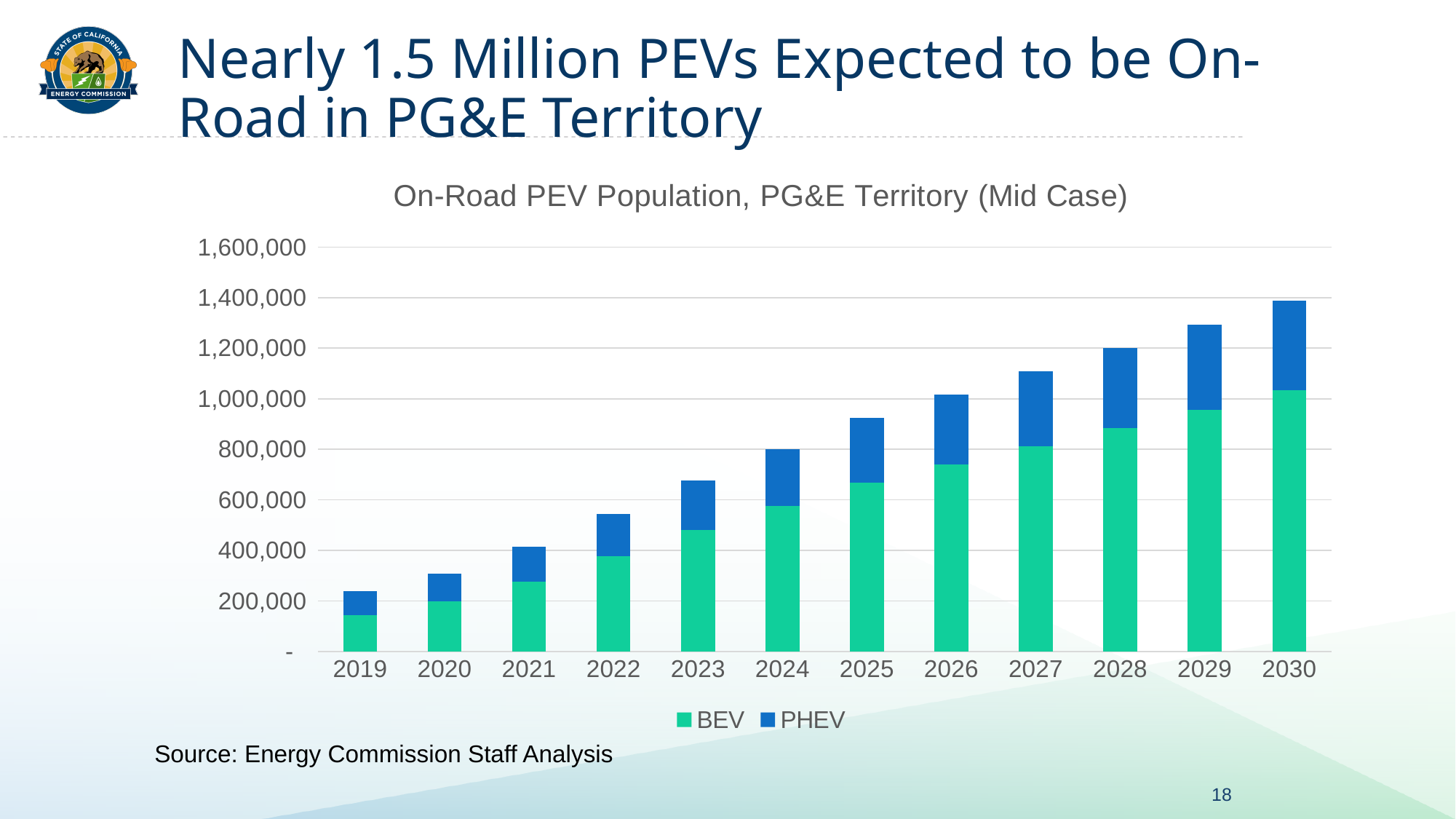
Which year has the lowest total on-road PEV population? 2019 How many series does the legend list? 2 Does the total on-road PEV population rise or fall from 2019 to 2030? Rises Is the total PEV population for 2025 greater or less than 800,000? greater What type of chart is shown on the slide? Stacked bar chart How many years are shown on the x axis? 12 Is the total PEV population for 2022 greater or less than 600,000? less Is the total PEV population for 2030 greater or less than 1,200,000? greater Which series is shown in green in the chart? BEV Which year has the highest total on-road PEV population? 2030 What is the title of the chart? On-Road PEV Population, PG&E Territory (Mid Case)